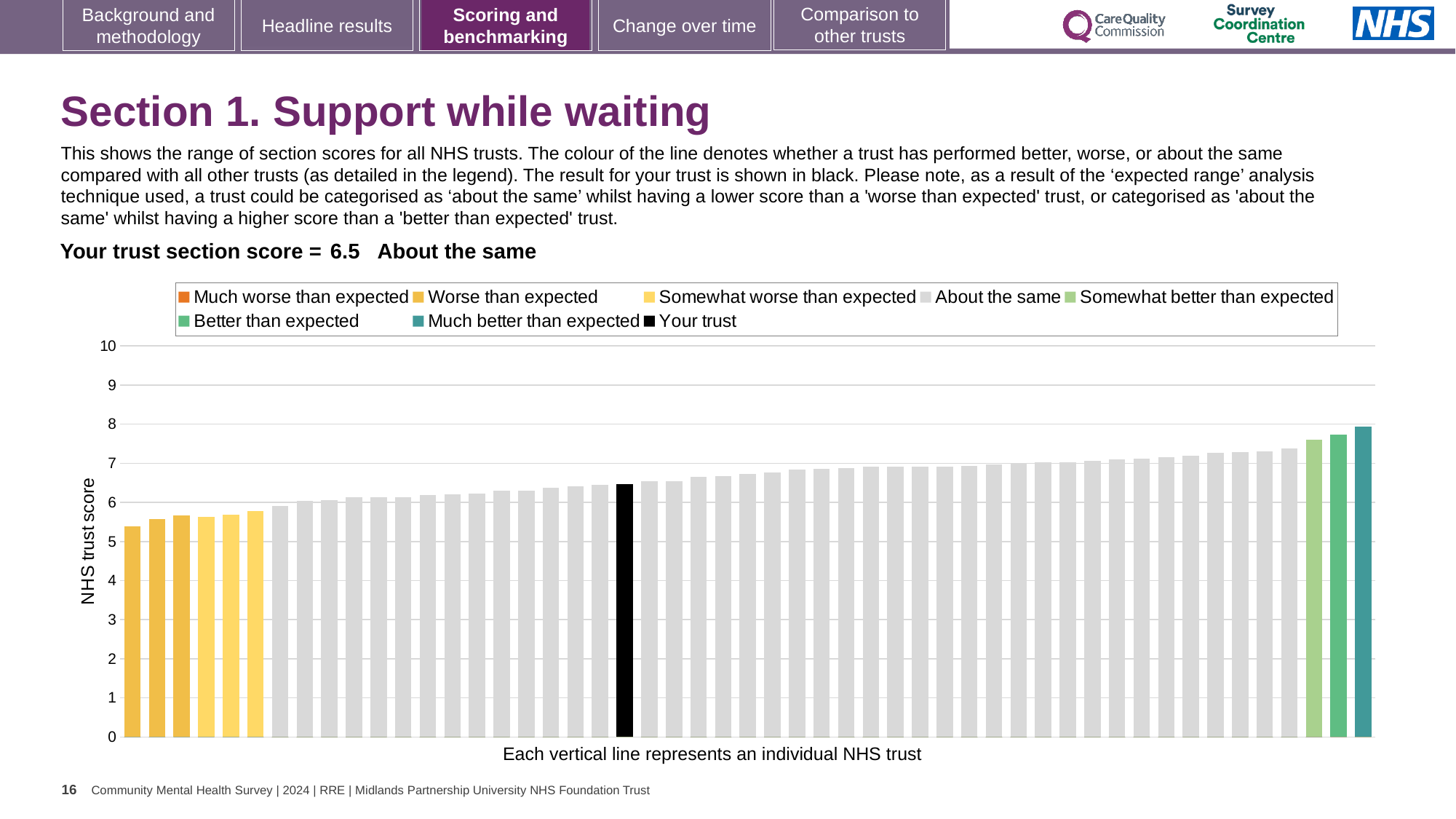
Do the bar values rise or fall from left to right along the x axis? rise What kind of chart is shown on the slide? bar chart What is the section score for your trust shown on the slide? 6.5 Which is larger: the black 'Your trust' bar or the leftmost bar in the chart? the black 'Your trust' bar Is the value of the leftmost (shortest) bar greater or less than 5? greater Is the value of the black 'Your trust' bar greater or less than 7? less What is the label on the vertical axis of the chart? NHS trust score How many entries does the chart legend list? 8 According to the slide, which category does your trust's section score fall into? About the same Is the value of the black 'Your trust' bar greater or less than 6? greater How many yellow (worse than expected) bars are at the left end of the chart? 6